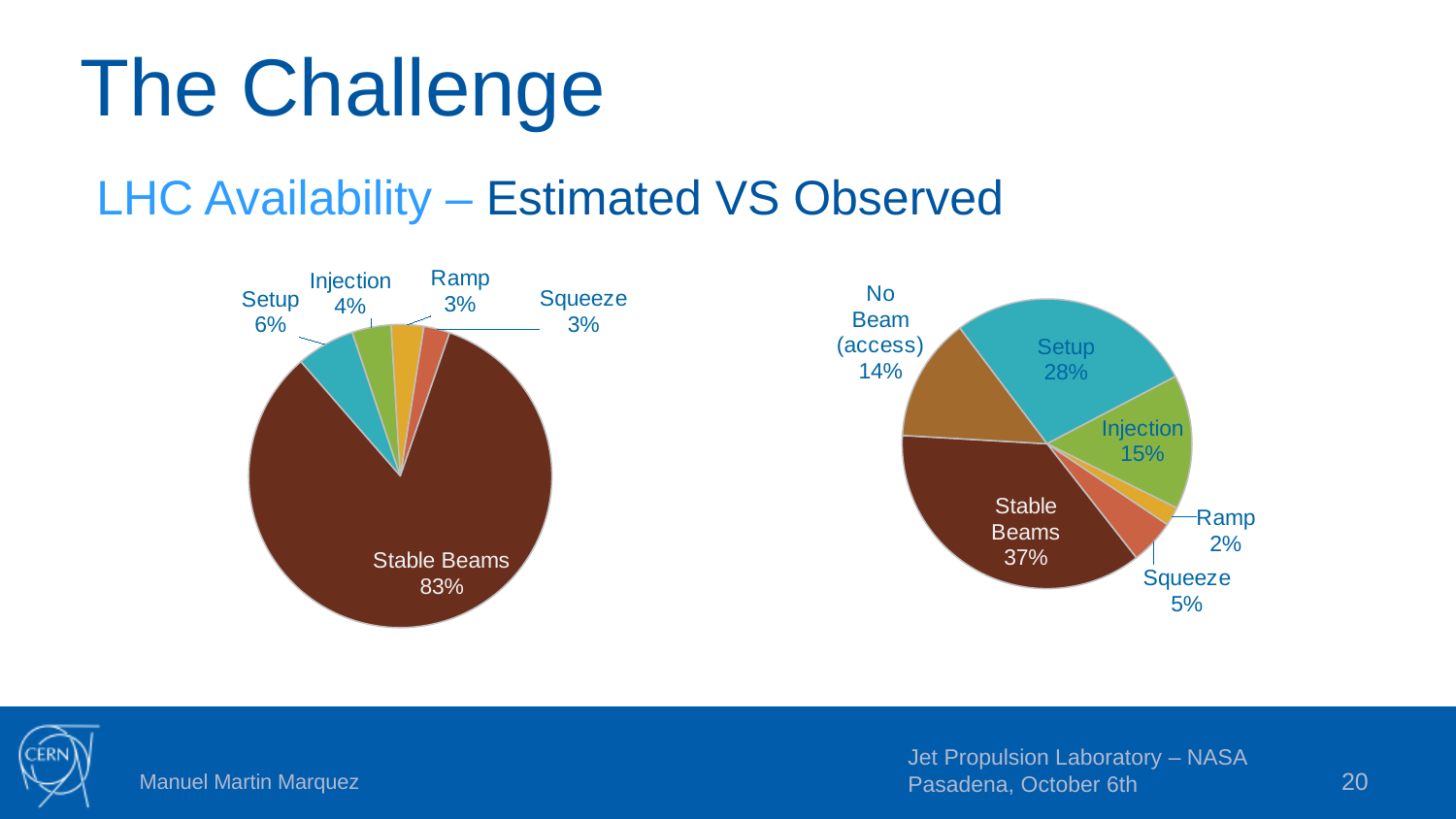
In the right pie chart, which category has the smallest share? Ramp In the right pie chart, what share does No Beam (access) have? 14% How many slices does the left pie chart have? 5 In the left pie chart, what share does Setup have? 6% In the right pie chart, what share does Setup have? 28% In the left pie chart, what share does Stable Beams have? 83% In the left pie chart, which category has the largest share? Stable Beams What is the difference between the Stable Beams share in the left pie chart and the Stable Beams share in the right pie chart? 46% What type of chart is shown on the left of the slide? Pie chart In the right pie chart, which is larger: the Setup share or the Injection share? Setup In the right pie chart, which category has the largest share? Stable Beams How many slices does the right pie chart have? 6